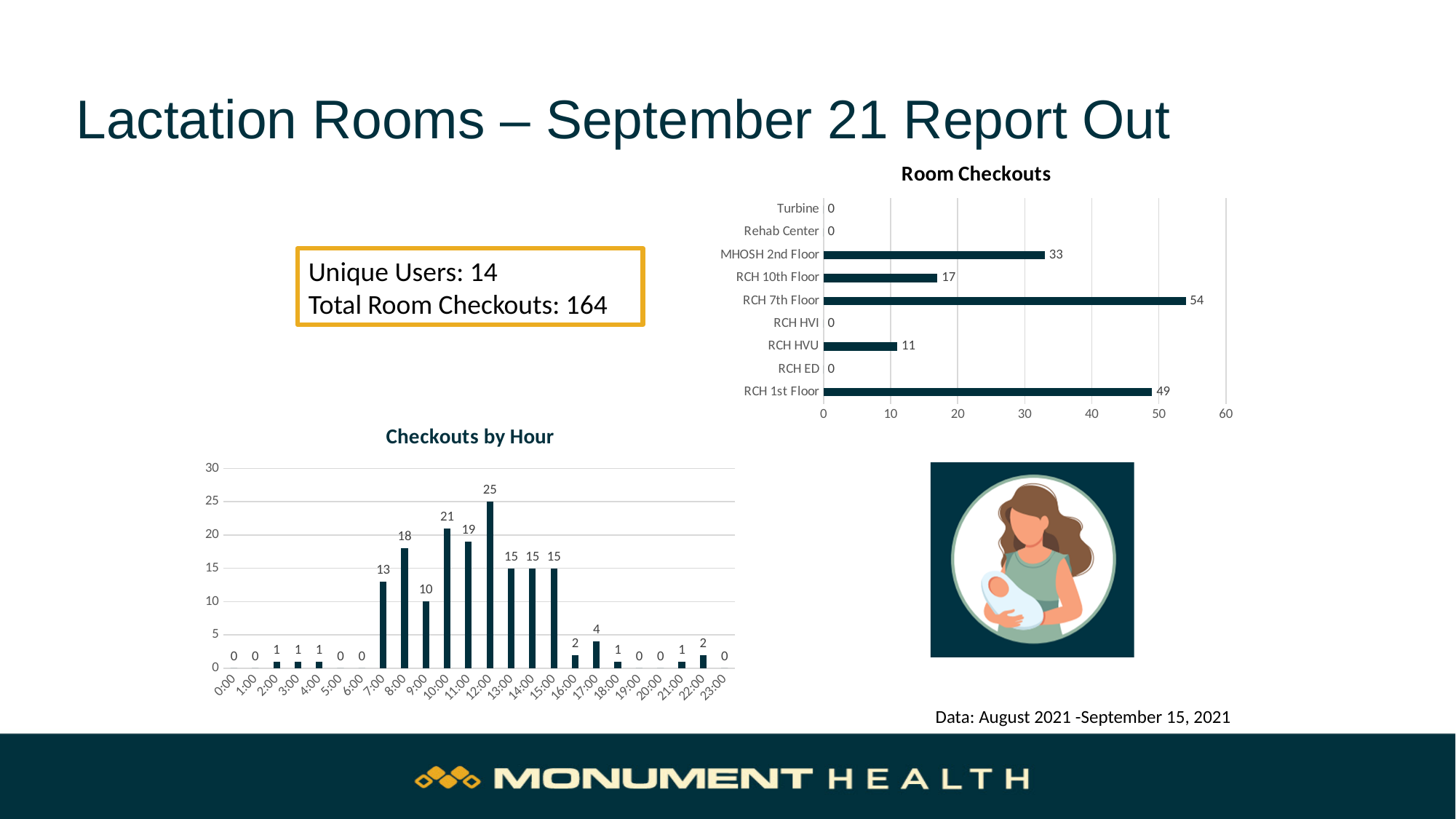
In the Room Checkouts chart, which is larger, RCH 10th Floor or RCH HVU? RCH 10th Floor In the Room Checkouts chart, what is the value for RCH 7th Floor? 54 In the Checkouts by Hour chart, how many hours are shown on the x axis? 24 In the Checkouts by Hour chart, what is the difference between 10:00 and 9:00? 11 In the Checkouts by Hour chart, which hour has the highest number of checkouts? 12:00 In the Room Checkouts chart, which location has the highest number of checkouts? RCH 7th Floor In the Room Checkouts chart, what is the difference between RCH 1st Floor and MHOSH 2nd Floor? 16 In the Checkouts by Hour chart, what is the value for 12:00? 25 In the Room Checkouts chart, how many locations are listed? 9 In the Checkouts by Hour chart, do the values rise or fall from 13:00 to 18:00? Fall What kind of chart is the Room Checkouts chart? Bar chart In the Room Checkouts chart, how many locations have a value of 0? 4